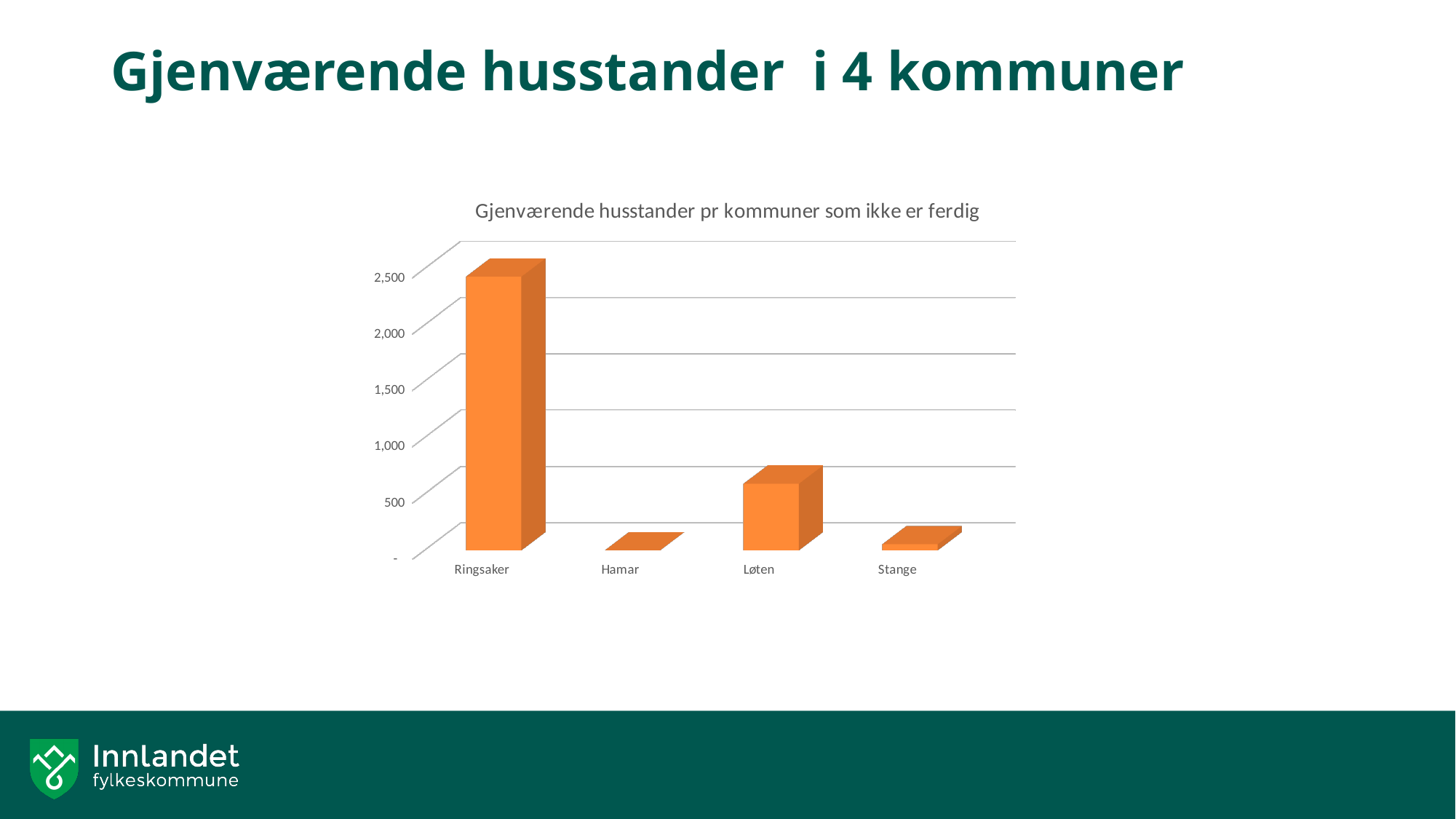
Which municipality has the highest number of remaining households in the chart? Ringsaker Is the value for Hamar greater or less than 500? less Which has a larger value, Ringsaker or Løten? Ringsaker Which has a larger value, Løten or Stange? Løten Is the value for Stange greater or less than 500? less What kind of chart is shown on the slide? bar chart Is the value for Løten greater or less than 1,000? less What colour are the bars in the chart? orange What is the title of the chart? Gjenværende husstander pr kommuner som ikke er ferdig Which municipality has the lowest number of remaining households in the chart? Hamar How many municipalities (categories) are shown on the x axis of the chart? 4